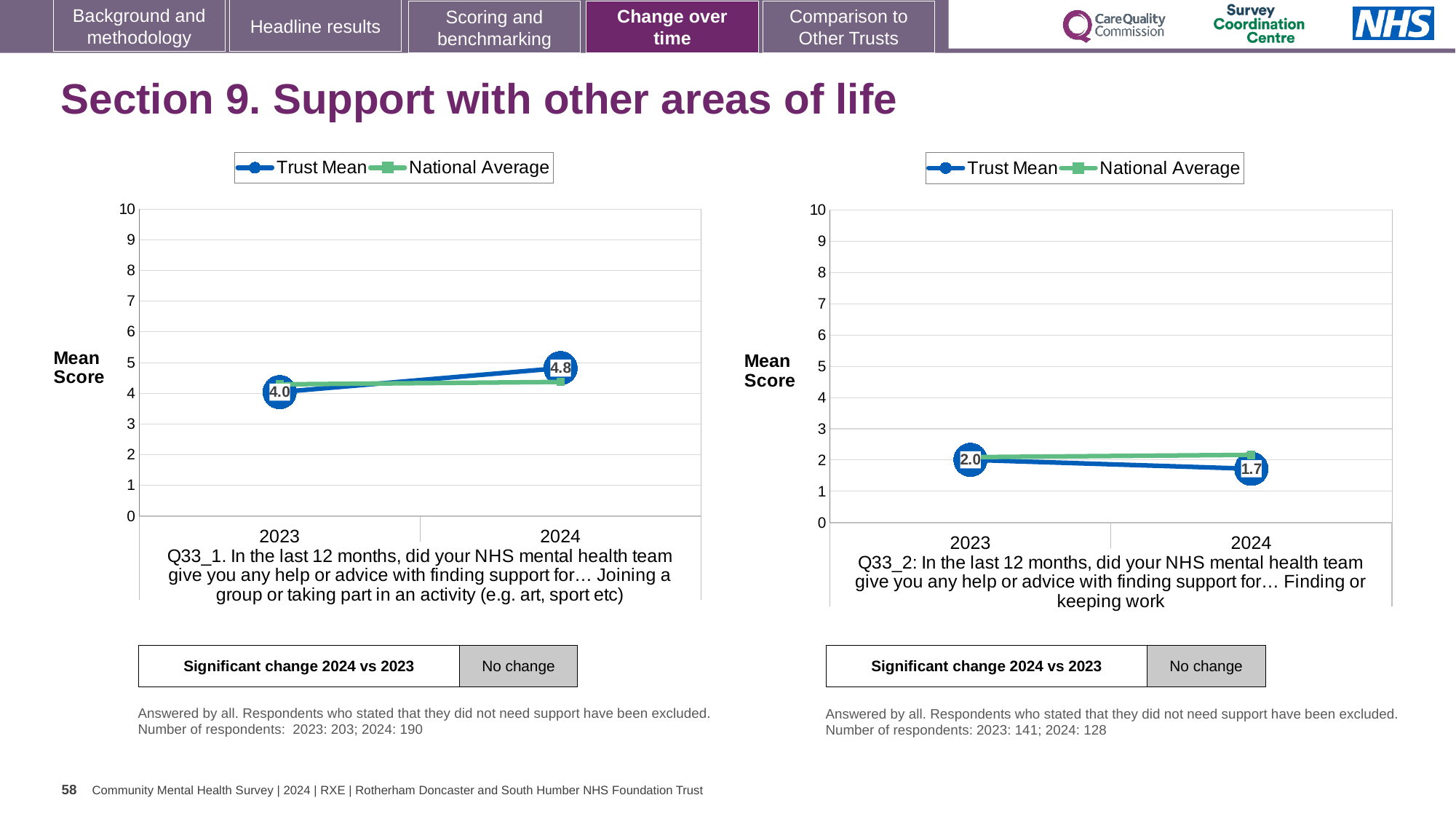
In the left chart (Q33_1), is the National Average value for 2024 greater or less than 5? less In the right chart (Q33_2), what is the difference between the Trust Mean in 2023 and 2024? 0.3 In the left chart (Q33_1), what is the Trust Mean score for 2024? 4.8 In the left chart (Q33_1), by how much did the Trust Mean change from 2023 to 2024? 0.8 In the right chart (Q33_2), which is larger in 2024, the Trust Mean or the National Average? National Average In the right chart (Q33_2), does the Trust Mean rise or fall from 2023 to 2024? fall What kind of chart is the left chart (Q33_1)? line chart In the left chart (Q33_1), does the Trust Mean rise or fall from 2023 to 2024? rise In the right chart (Q33_2), what is the Trust Mean score for 2023? 2.0 In the right chart (Q33_2), what is the Trust Mean score for 2024? 1.7 In the left chart (Q33_1), what is the Trust Mean score for 2023? 4.0 How many series does the legend of the right chart (Q33_2) list? 2